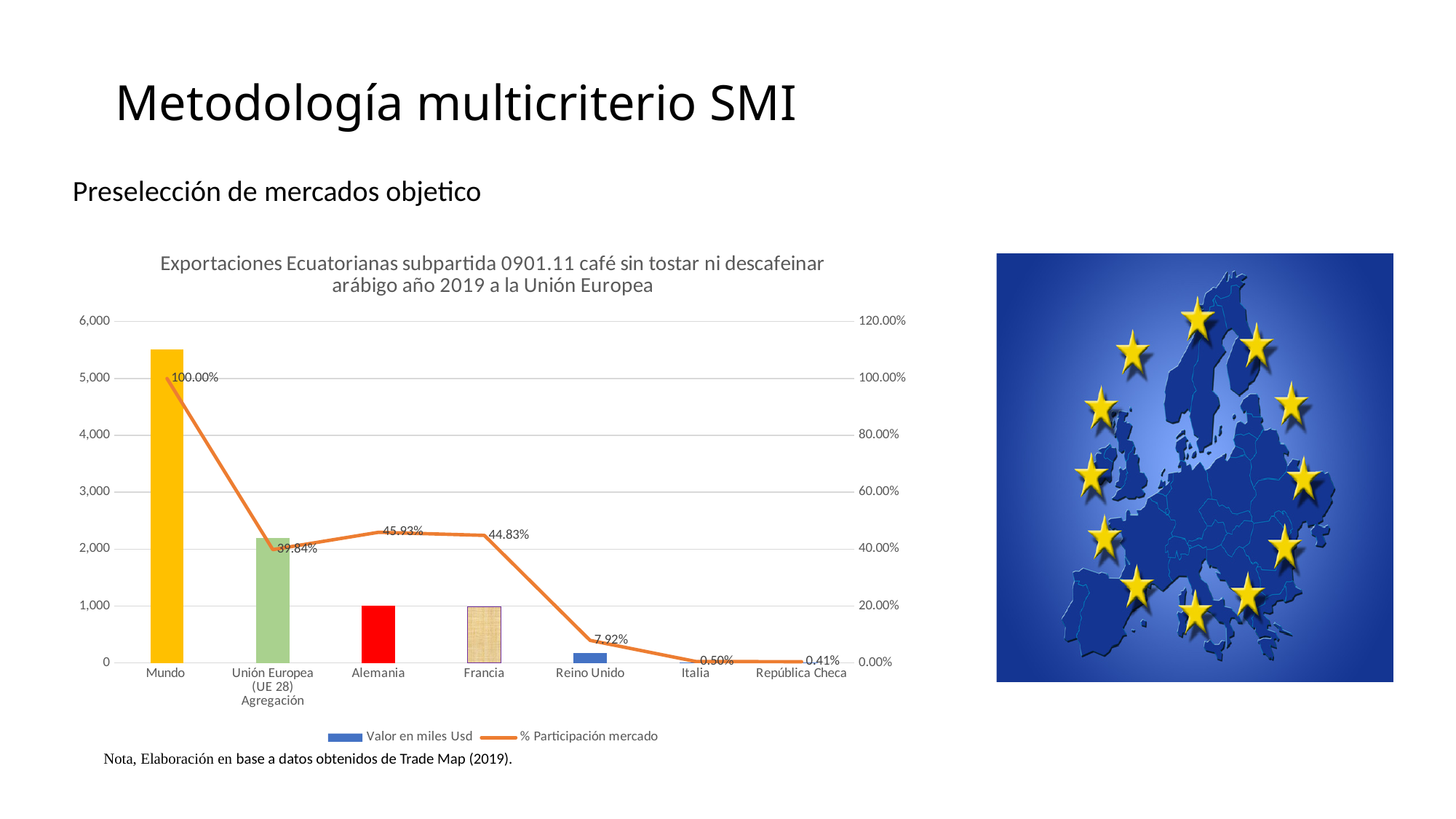
What is the % Participación mercado value for Francia? 44.83% What kind of chart is shown on the slide? Combined bar and line chart How many categories are shown on the x axis? 7 How many series does the legend list? 2 Which category has the highest Valor en miles Usd bar? Mundo Which category has the lowest % Participación mercado value? República Checa Which has a larger % Participación mercado value, Italia or Reino Unido? Reino Unido Is the Valor en miles Usd bar for Mundo greater or less than 5,000? greater What is the % Participación mercado value for Reino Unido? 7.92% What is the difference between the % Participación mercado values for Alemania and Francia? 1.10% What is the % Participación mercado value for Alemania? 45.93% What is the % Participación mercado value for Unión Europea (UE 28) Agregación? 39.84%